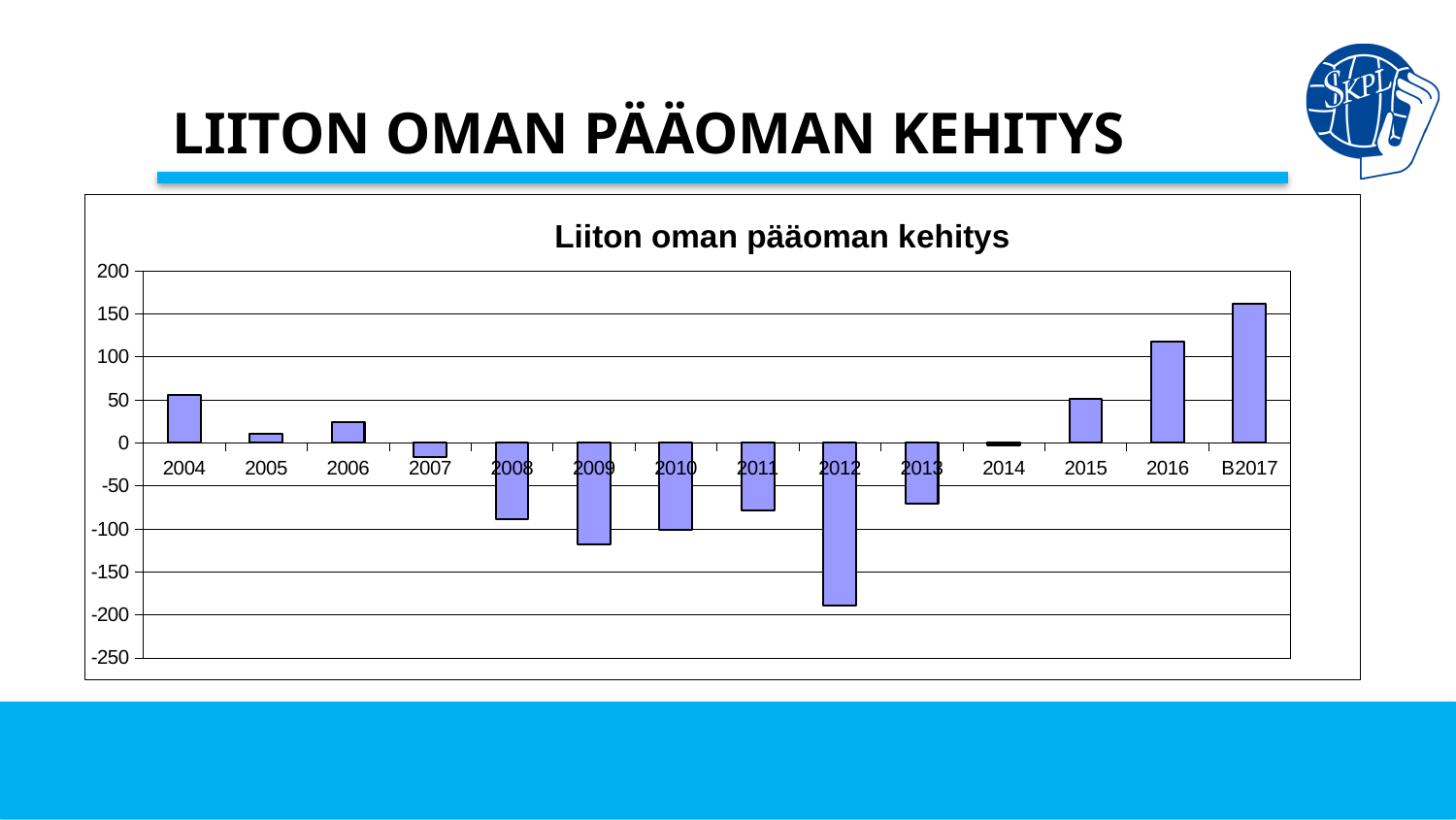
Which category has the highest value in the chart? B2017 Do the values rise or fall from 2013 to B2017? rise Is the value for 2008 greater or less than -50? less Is the value for 2016 greater or less than 100? greater What type of chart is shown on the slide? bar chart Is the value for 2012 greater or less than -150? less How many categories are shown on the x axis of the chart? 14 What is the title of the chart? Liiton oman pääoman kehitys Which category has the lowest value in the chart? 2012 Which is larger, the value for 2015 or the value for 2016? 2016